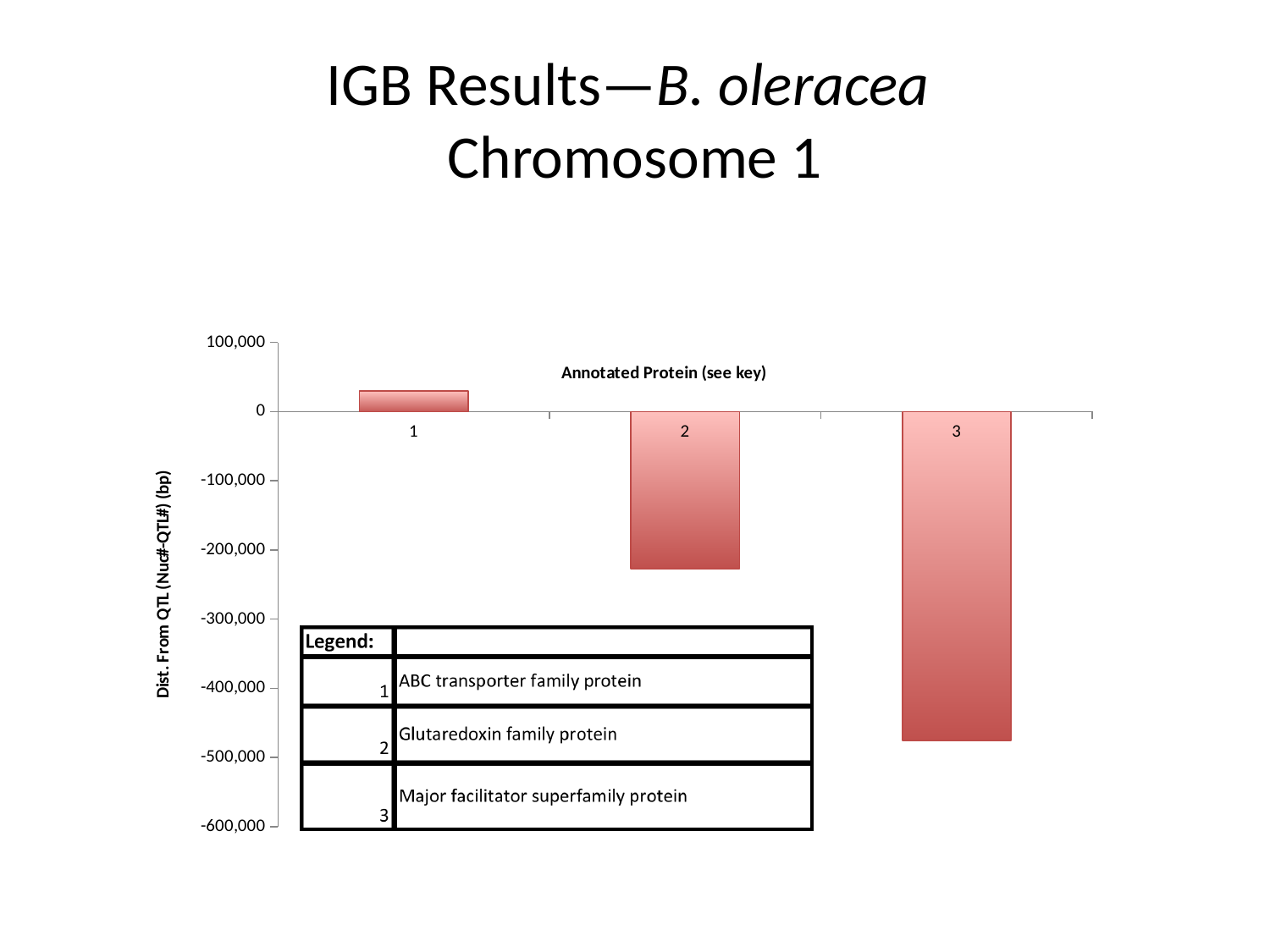
Is the value for category 2 greater or less than -100,000? less Is the value for category 2 greater or less than -300,000? greater Do the values rise or fall moving from category 1 to category 3 along the x axis? fall What kind of chart is shown on the slide? bar chart Is the value for category 1 greater or less than 0? greater What is the title of the vertical axis of the chart? Dist. From QTL (Nuc#-QTL#) (bp) According to the legend key, which protein does category 2 represent? Glutaredoxin family protein Which category has the lowest value in the chart? 3 Which category has the highest value in the chart? 1 How many bars (categories) are plotted in the chart? 3 Which has the larger value, category 2 or category 3? 2